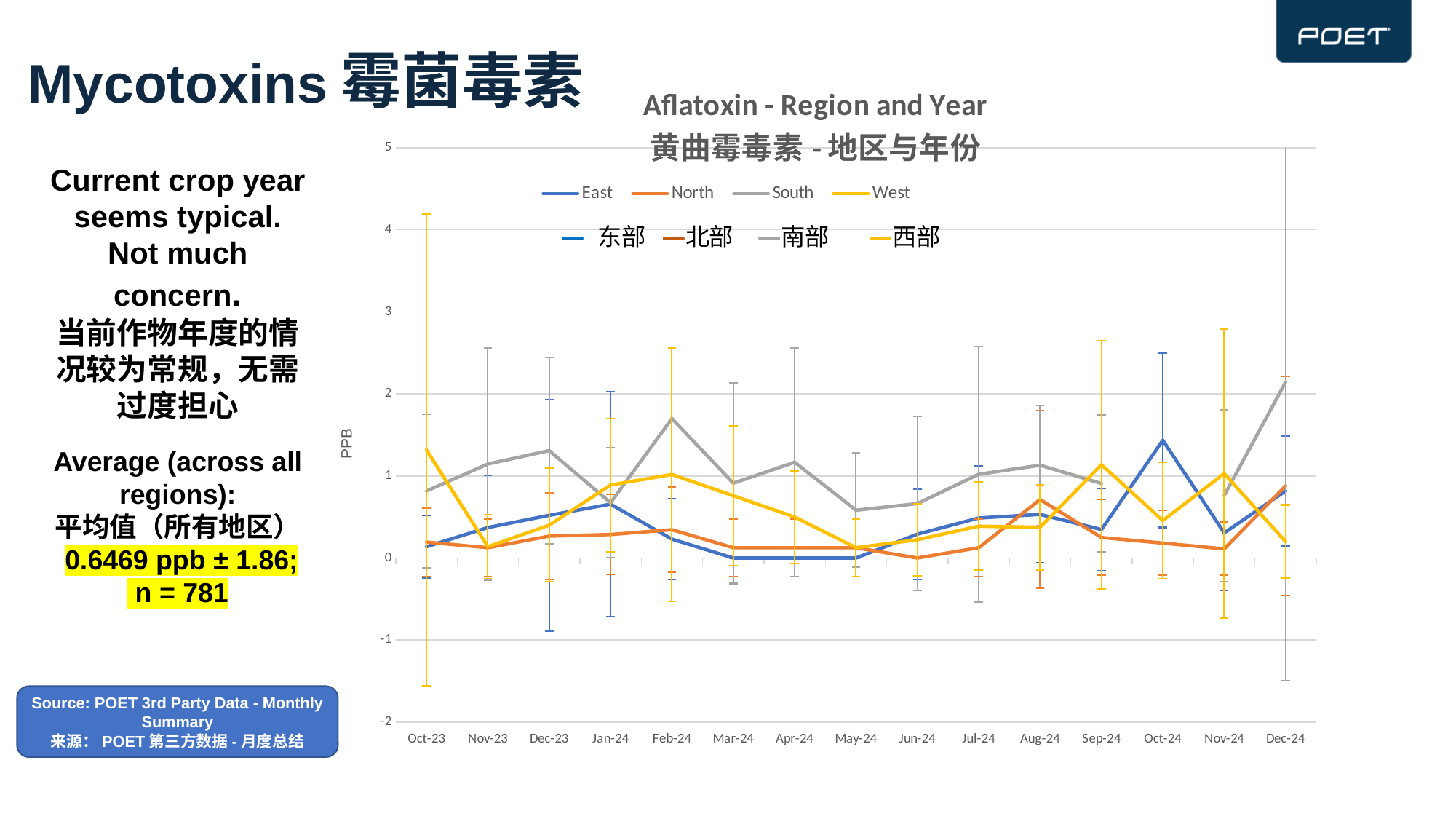
In Oct-24, which is larger, the value for East or the value for North? East Is the value for North in Mar-24 greater or less than 1? less What kind of chart is shown on the slide? line chart Does the South line rise or fall from Nov-24 to Dec-24? rise What is the English title of the chart? Aflatoxin - Region and Year Is the value for South in Feb-24 greater or less than 1? greater How many months are plotted along the x axis of the chart? 15 In Feb-24, which is larger, the value for South or the value for North? South What is the label on the y axis of the chart? PPB In Dec-24, which series has the highest value? South Is the value for East in Oct-24 greater or less than 1? greater How many series does the chart legend list? 4